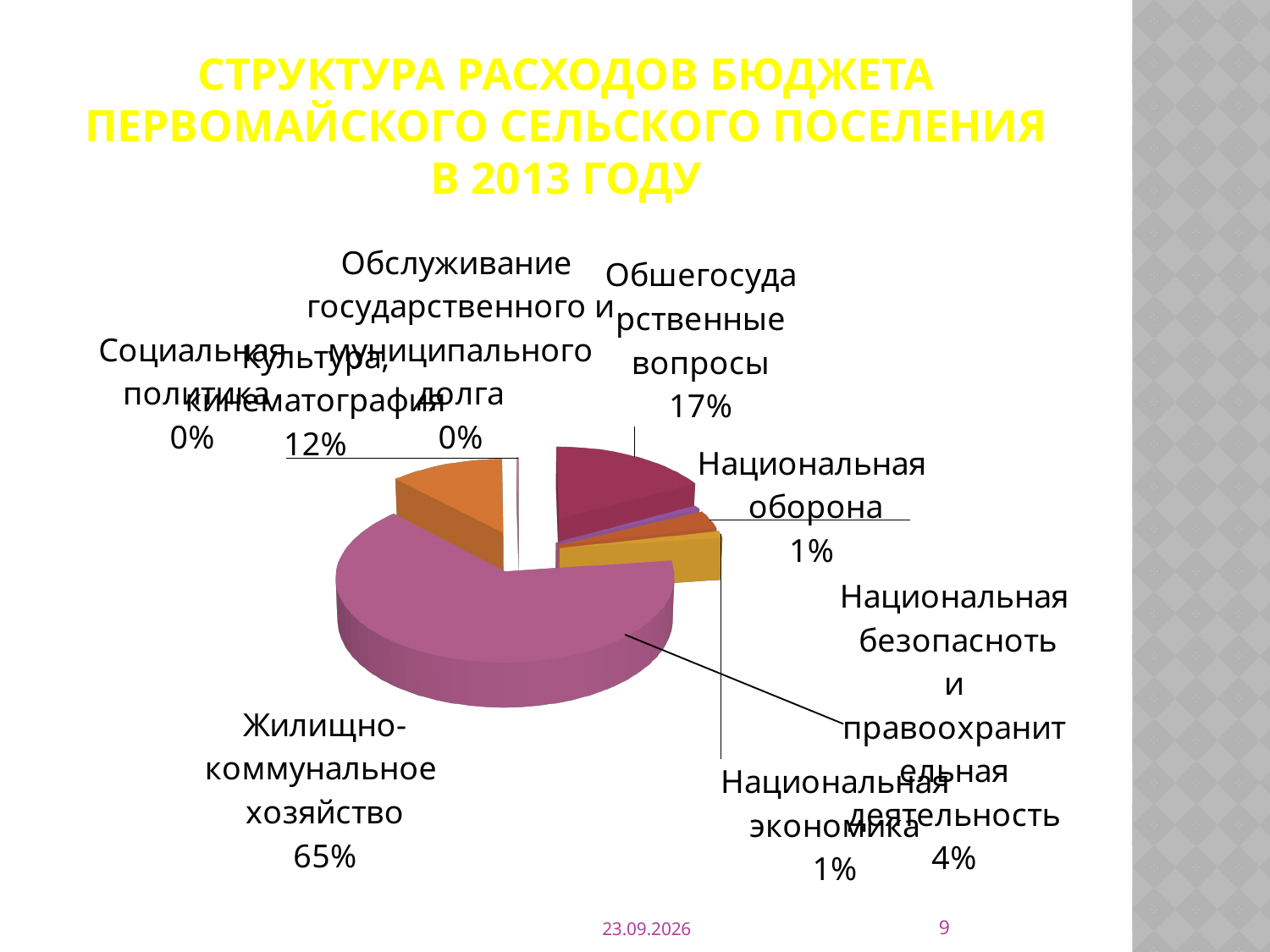
How many categories are labelled on the pie chart? 8 What share of the budget expenditure goes to Жилищно-коммунальное хозяйство? 65% Which is larger: the share for Культура, кинематография or the share for Национальная безопасность и правоохранительная деятельность? Культура, кинематография What percentage is shown for Национальная безопасность и правоохранительная деятельность? 4% What is the difference in percentage points between Жилищно-коммунальное хозяйство and Общегосударственные вопросы? 48 Which category has the largest share of the pie? Жилищно-коммунальное хозяйство What percentage is shown for Общегосударственные вопросы? 17% What share is shown for Национальная оборона? 1% What share is labelled for Культура, кинематография? 12% What percentage is shown for Социальная политика? 0% What kind of chart is shown on the slide? Pie chart What year does the chart title say the budget expenditure structure refers to? 2013